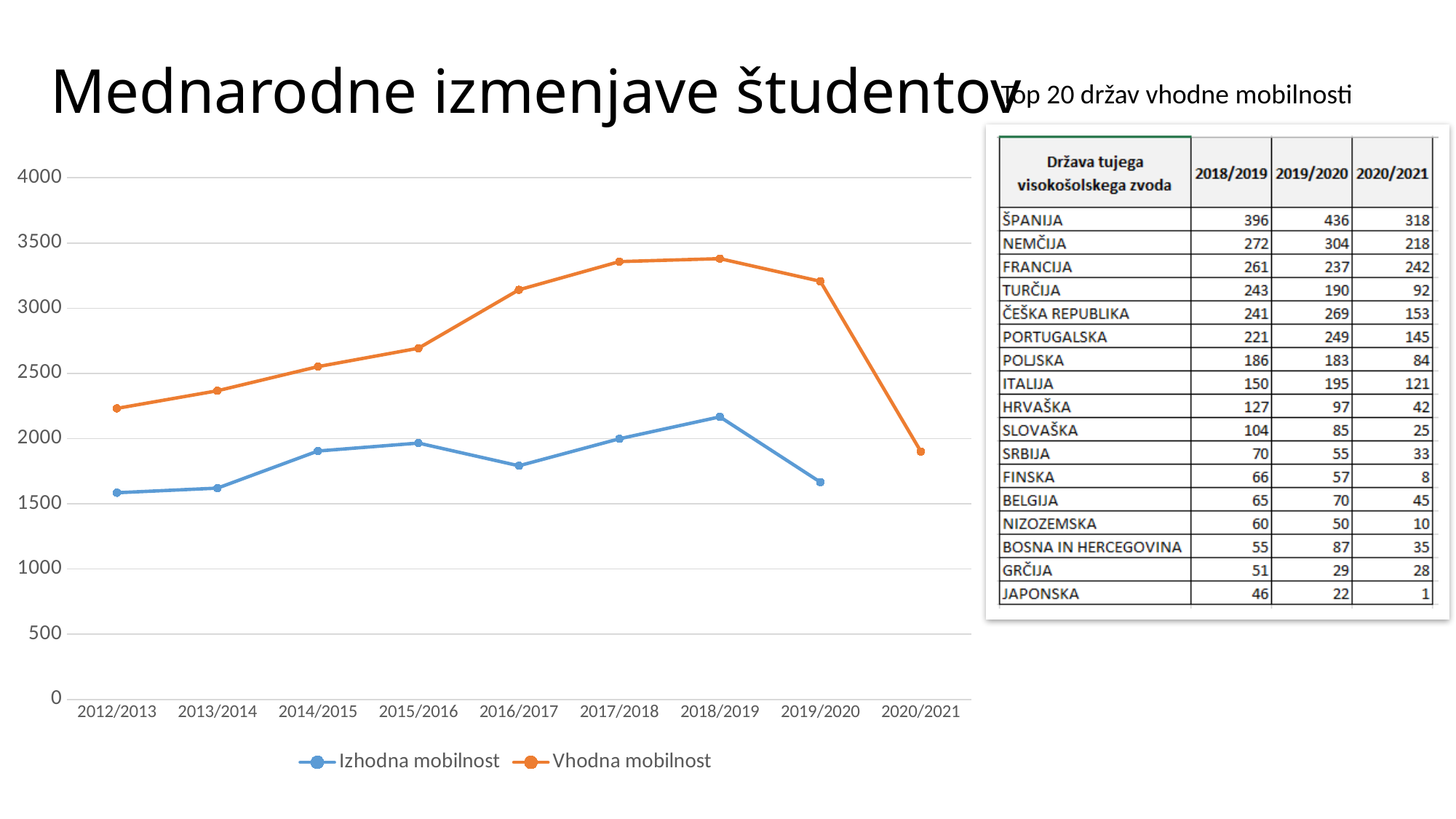
In the line chart, is the value for Izhodna mobilnost in 2016/2017 greater or less than 2000? less How many academic years are shown on the x axis of the line chart? 9 In the line chart, which series has the larger value in 2018/2019, Izhodna mobilnost or Vhodna mobilnost? Vhodna mobilnost In the line chart, is the value for Izhodna mobilnost in 2018/2019 greater or less than 2000? greater In the line chart, is the value for Vhodna mobilnost in 2018/2019 greater or less than 3000? greater In the line chart, does Vhodna mobilnost rise or fall from 2012/2013 to 2018/2019? rise What kind of chart is shown on the left of the slide? line chart In the line chart, in which academic year does Izhodna mobilnost reach its highest value? 2018/2019 How many series does the legend of the line chart list? 2 In the line chart, in which academic year does Vhodna mobilnost reach its lowest value? 2020/2021